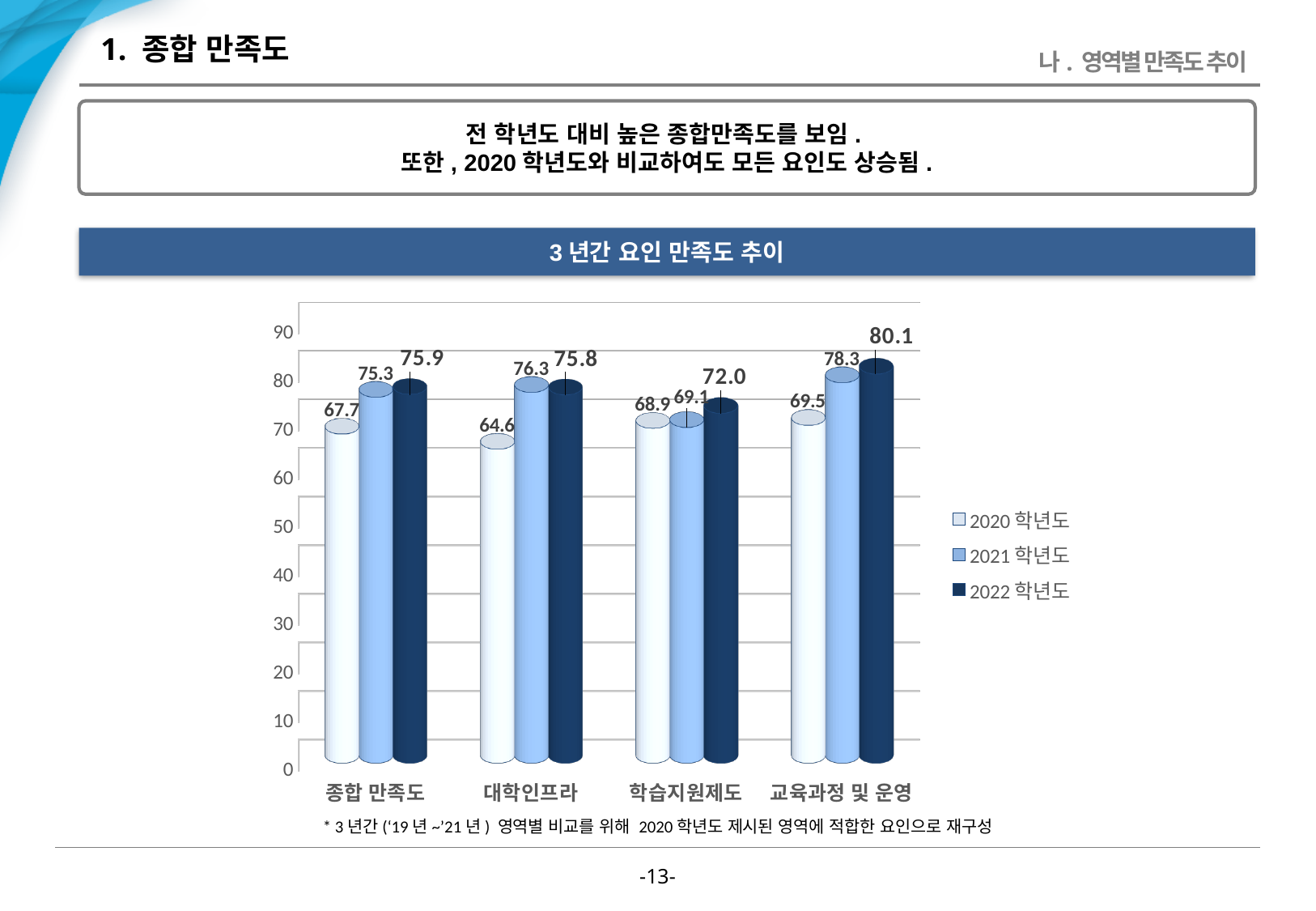
How many series does the legend list? 3 Is the 2020 학년도 value for 학습지원제도 greater or less than 70? less What is the value for 학습지원제도 in the 2022 학년도 series? 72.0 Which is larger for 대학인프라: the 2021 학년도 value or the 2022 학년도 value? 2021 학년도 Which category has the highest value in the 2022 학년도 series? 교육과정 및 운영 What kind of chart is shown on the slide? bar chart How many categories are shown on the x axis? 4 What is the value for 종합 만족도 in the 2020 학년도 series? 67.7 What is the difference between the 2022 학년도 and 2020 학년도 values for 교육과정 및 운영? 10.6 What is the value for 대학인프라 in the 2021 학년도 series? 76.3 What is the value for 교육과정 및 운영 in the 2022 학년도 series? 80.1 Which category has the lowest value in the 2020 학년도 series? 대학인프라